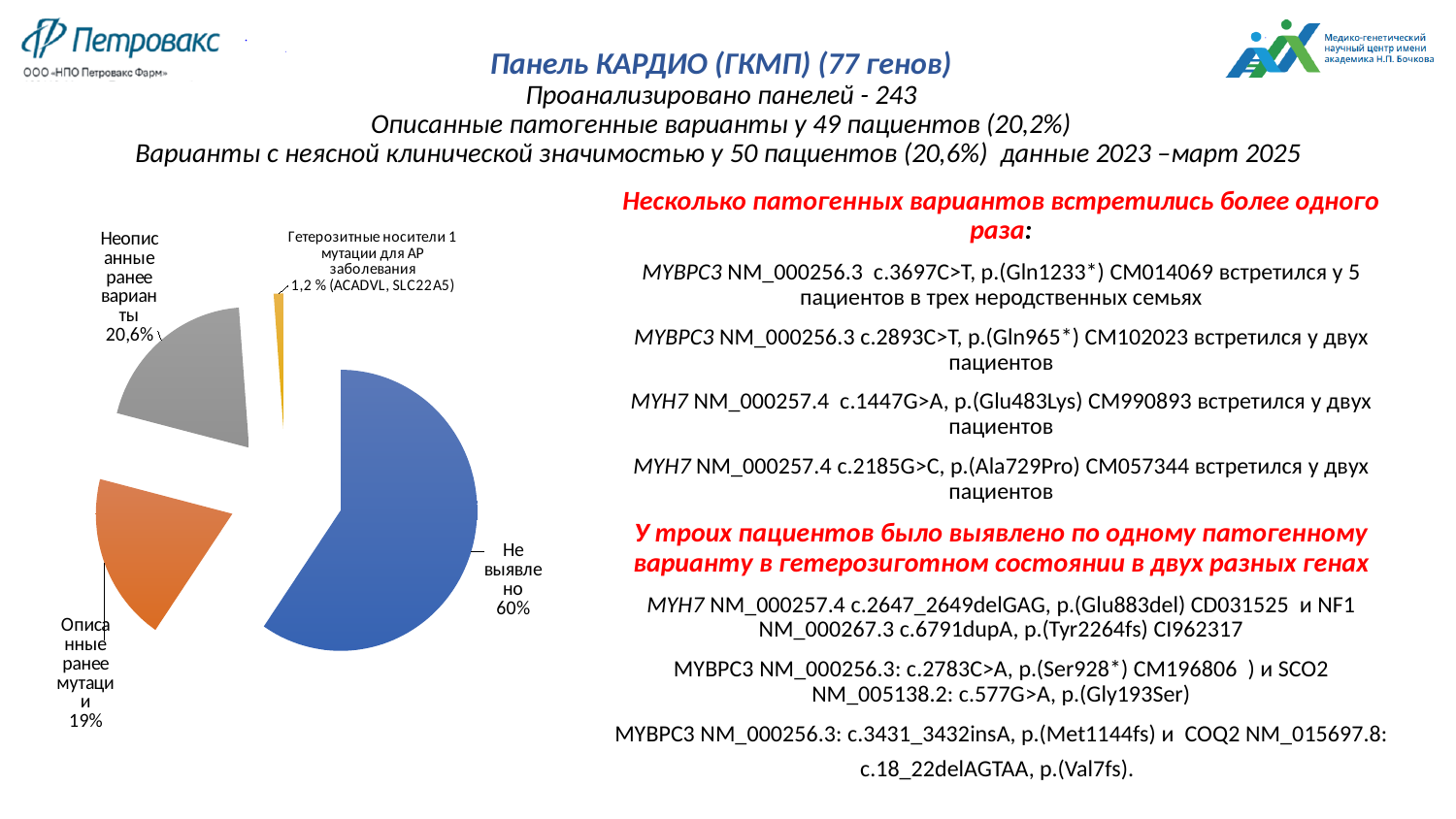
What percentage is shown for the "Не выявлено" slice of the pie chart? 60% Which slice is larger: "Неописанные ранее варианты" or "Описанные ранее мутации"? Неописанные ранее варианты What colour is the "Не выявлено" slice of the pie chart? Blue What type of chart is shown on the slide? Pie chart What percentage is shown for the "Описанные ранее мутации" slice? 19% Which slice of the pie chart is the largest? Не выявлено How many slices does the pie chart have? 4 What is the difference in percentage points between the "Не выявлено" slice and the "Описанные ранее мутации" slice? 41 What percentage is shown for the "Неописанные ранее варианты" slice? 20,6% Which genes are named in the label of the "Гетерозитные носители 1 мутации для АР заболевания" slice? ACADVL, SLC22A5 What percentage is shown for the "Гетерозитные носители 1 мутации для АР заболевания" slice? 1,2 % Which slice of the pie chart is the smallest? Гетерозитные носители 1 мутации для АР заболевания